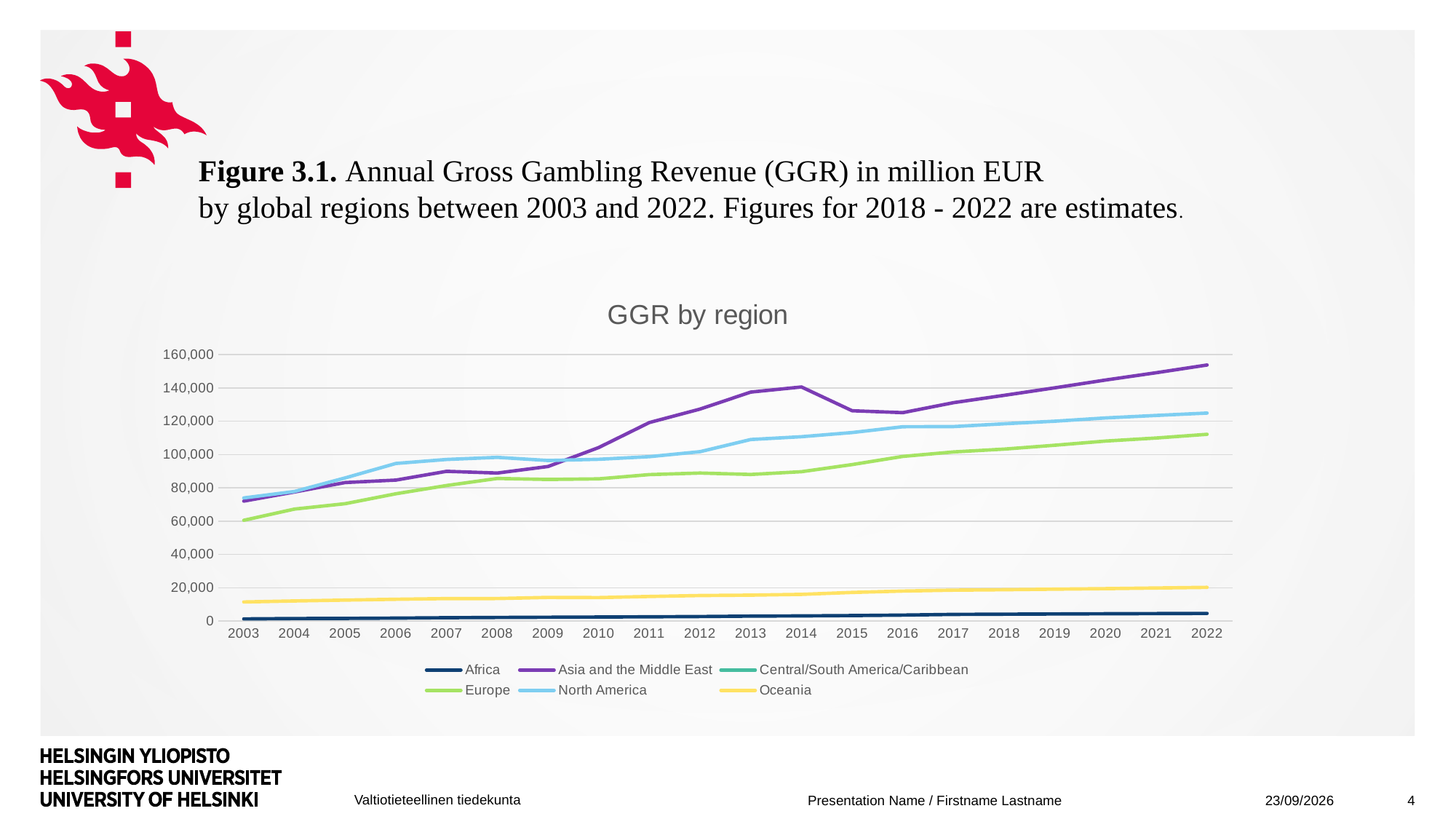
Is the value for Europe in 2022 greater or less than 100,000? greater What is the title of the chart? GGR by region Does the GGR for Europe rise or fall overall from 2003 to 2022? rise Which region has the highest GGR in 2022? Asia and the Middle East How many series does the legend of the GGR by region chart list? 6 Is the value for Asia and the Middle East in 2022 greater or less than 140,000? greater What kind of chart is shown on the slide? line chart In 2006, which is larger: the value for North America or the value for Europe? North America How many years are shown along the x axis of the GGR by region chart? 20 Is the value for Oceania in 2022 greater or less than 40,000? less Which region has the lowest GGR in 2022? Africa